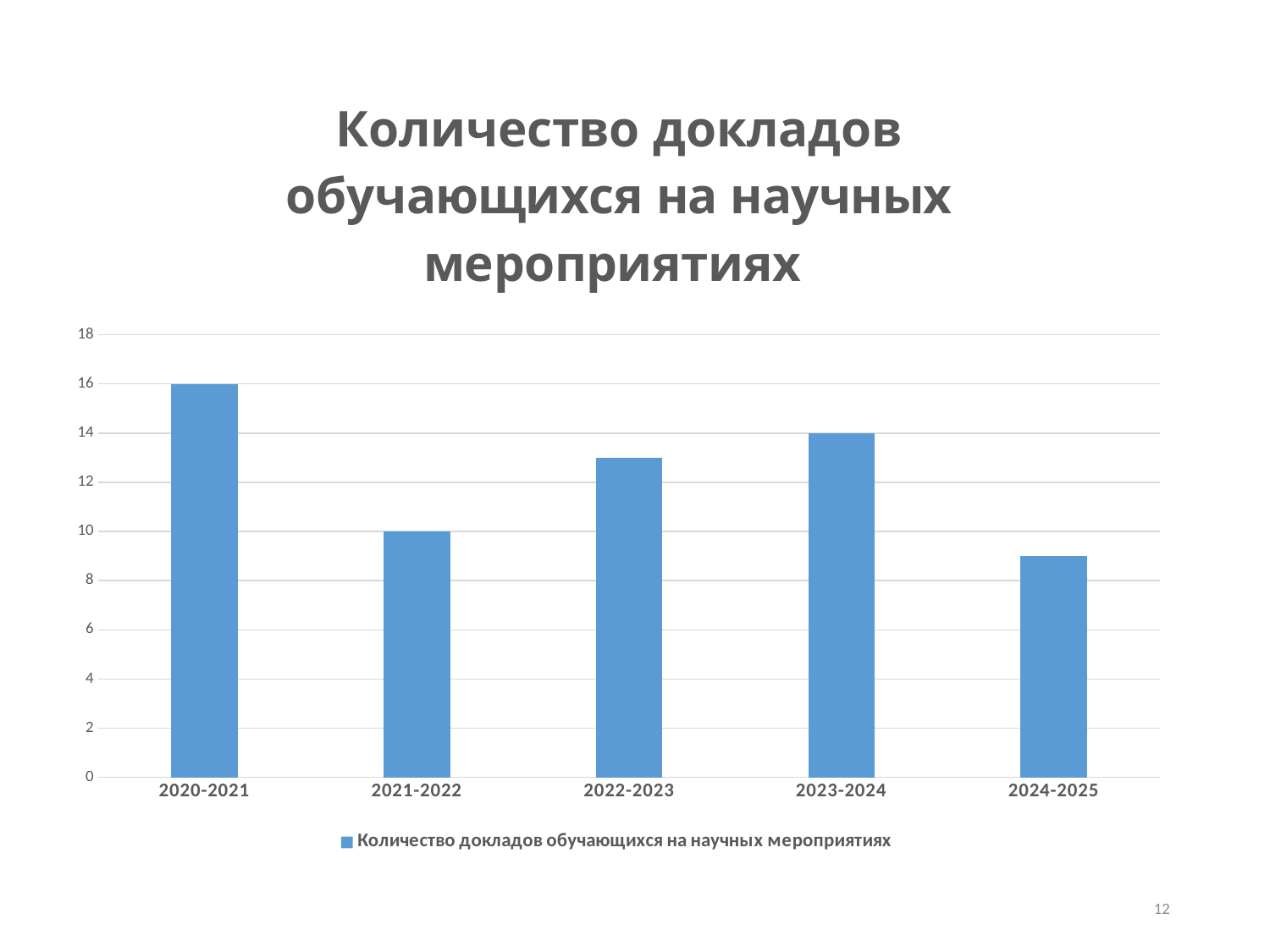
Which is larger, the value for 2022-2023 or the value for 2021-2022? 2022-2023 Is the value for 2022-2023 greater or less than 12? greater Which academic year has the lowest value? 2024-2025 What is the difference between the values for 2020-2021 and 2021-2022? 6 How many academic years are shown on the x axis? 5 What kind of chart is shown on the slide? bar chart What is the value for 2021-2022? 10 Is the value for 2024-2025 greater or less than 10? less What is the difference between the values for 2023-2024 and 2021-2022? 4 What is the value for 2020-2021? 16 Which academic year has the highest value? 2020-2021 What is the value for 2023-2024? 14